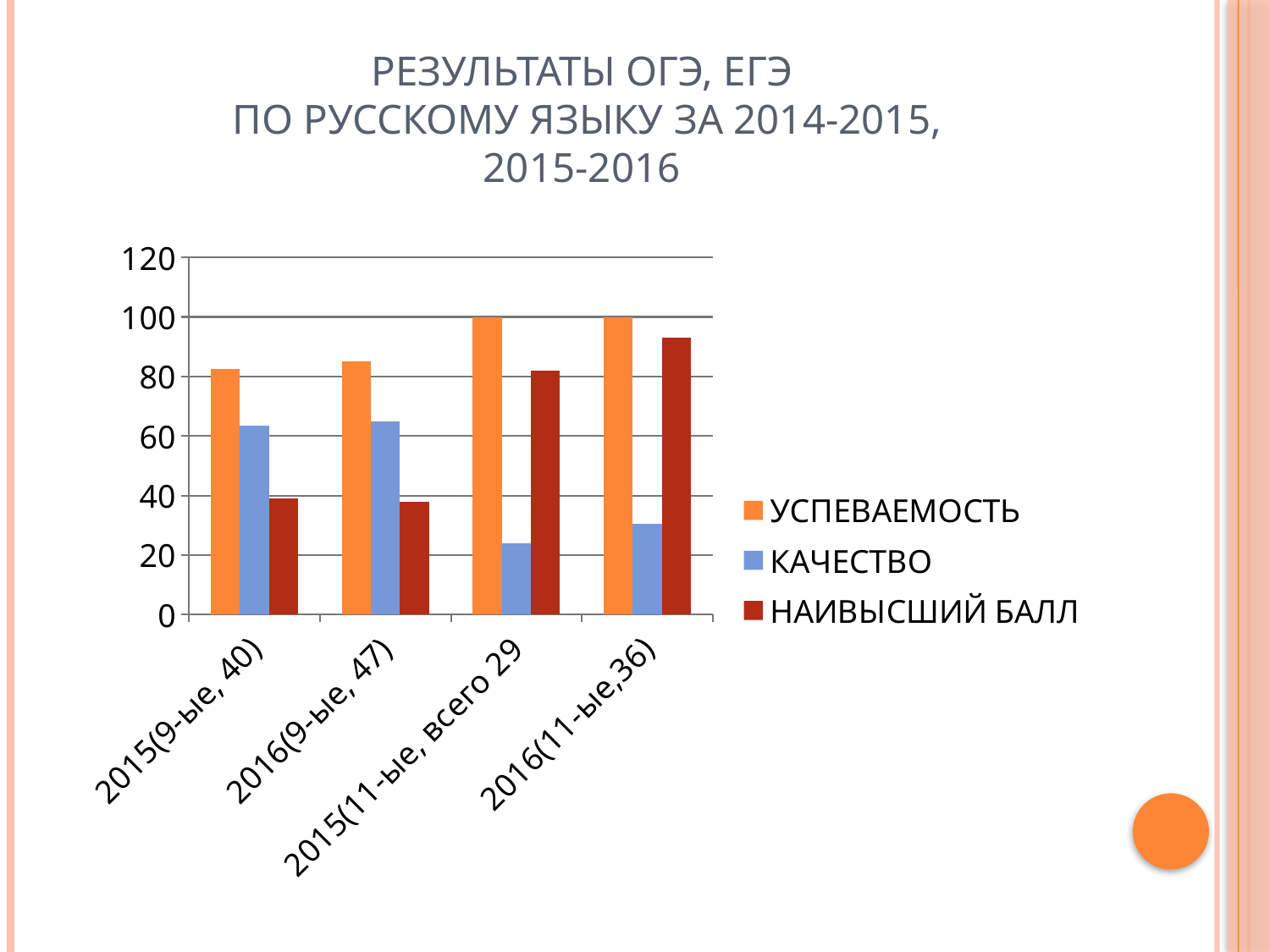
How many categories are shown on the x axis? 4 How many series does the legend list? 3 Is the УСПЕВАЕМОСТЬ value for 2016(9-ые, 47) greater or less than 100? less What is the УСПЕВАЕМОСТЬ value for 2015(11-ые, всего 29)? 100 Which category has the lowest КАЧЕСТВО value? 2015(11-ые, всего 29) Is the НАИВЫСШИЙ БАЛЛ value for 2016(11-ые,36) greater or less than 80? greater What is the УСПЕВАЕМОСТЬ value for 2016(11-ые,36)? 100 Is the КАЧЕСТВО value for 2015(11-ые, всего 29) greater or less than 40? less Which category has the highest НАИВЫСШИЙ БАЛЛ value? 2016(11-ые,36) What kind of chart is shown on the slide? bar chart For 2015(9-ые, 40), which is larger: КАЧЕСТВО or НАИВЫСШИЙ БАЛЛ? КАЧЕСТВО